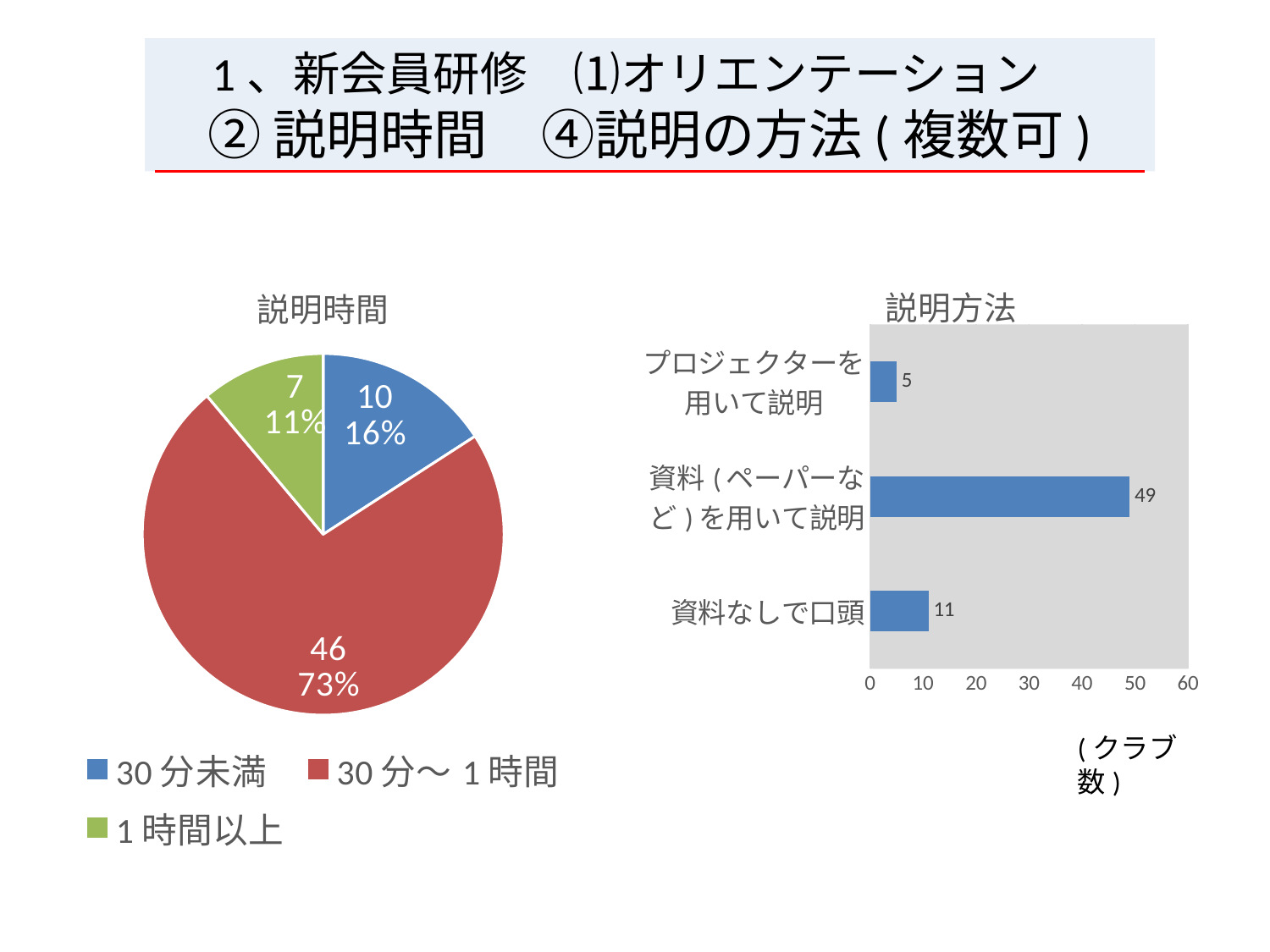
In the 説明時間 pie chart, what is the difference between the counts for 30分～1時間 and 30分未満? 36 In the 説明方法 bar chart, what is the value for 資料(ペーパーなど)を用いて説明? 49 In the 説明時間 pie chart, which category has the smallest slice? 1時間以上 In the 説明方法 bar chart, what is the value for プロジェクターを用いて説明? 5 In the 説明方法 bar chart, which is larger: 資料なしで口頭 or プロジェクターを用いて説明? 資料なしで口頭 In the 説明時間 pie chart, what is the count for 30分～1時間? 46 In the 説明時間 pie chart, which category has the largest slice? 30分～1時間 In the 説明時間 pie chart, how many categories does the legend list? 3 In the 説明時間 pie chart, what percentage share does 30分未満 have? 16% In the 説明方法 bar chart, which category has the lowest value? プロジェクターを用いて説明 What kind of chart is the 説明方法 chart on the right? bar chart In the 説明方法 bar chart, what is the difference between 資料(ペーパーなど)を用いて説明 and 資料なしで口頭? 38